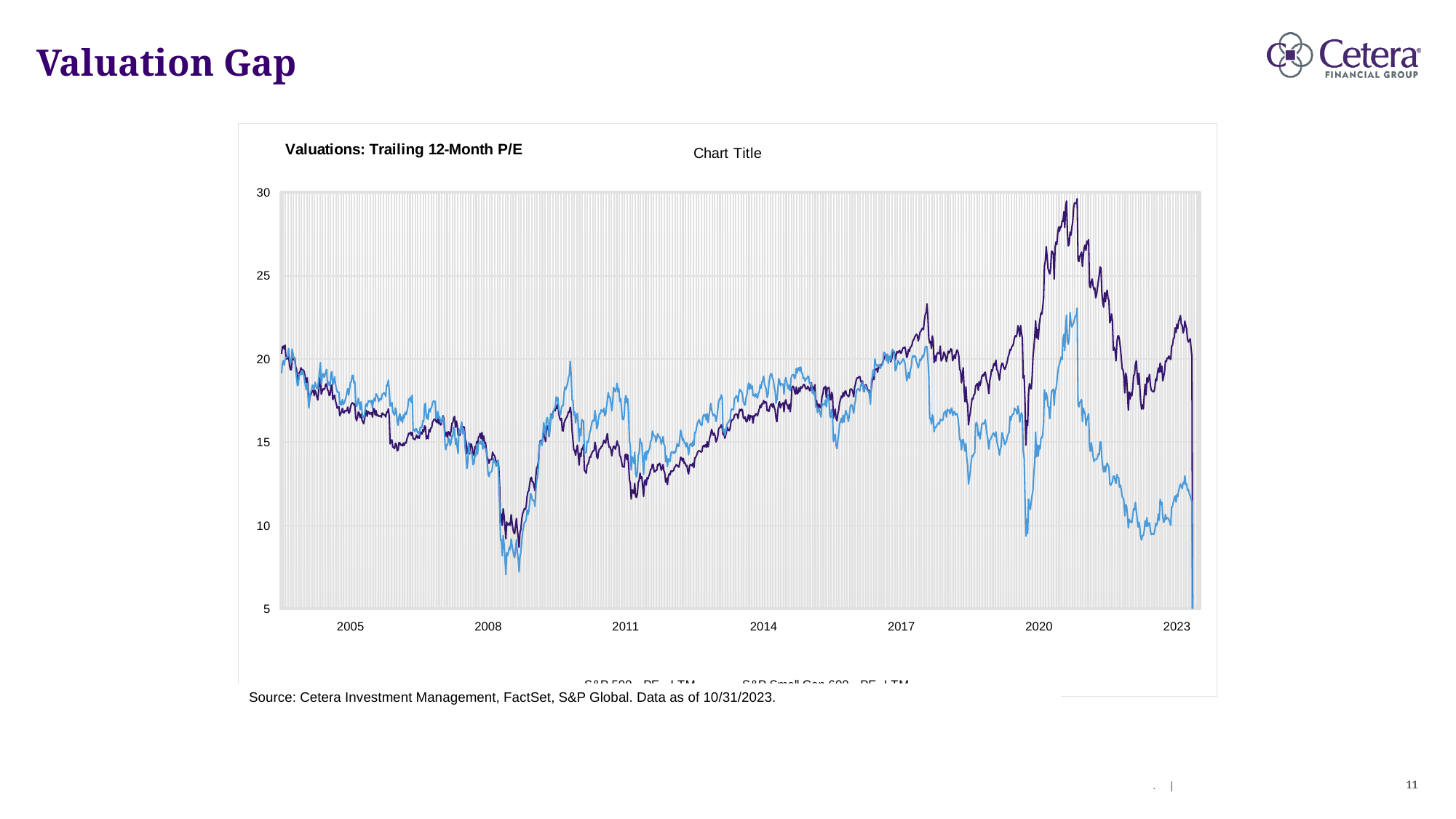
Around 2022, which line is higher, the dark purple line or the light blue line? the dark purple line Does the light blue line rise or fall from its 2021 peak to 2022? fall Is the peak value of the light blue line around 2021 greater or less than 20? greater Which line reaches the highest value on the chart, the dark purple line or the light blue line? the dark purple line Is the value of the light blue line in late 2022 greater or less than 15? less How many year labels are shown on the x axis? 7 How many series does the chart's legend list? 2 What kind of chart is shown on the slide? line chart What is the highest value shown on the y axis? 30 Is the lowest value of the light blue line around 2009 greater or less than 10? less What is the title printed above the chart's plot area on the left? Valuations: Trailing 12-Month P/E